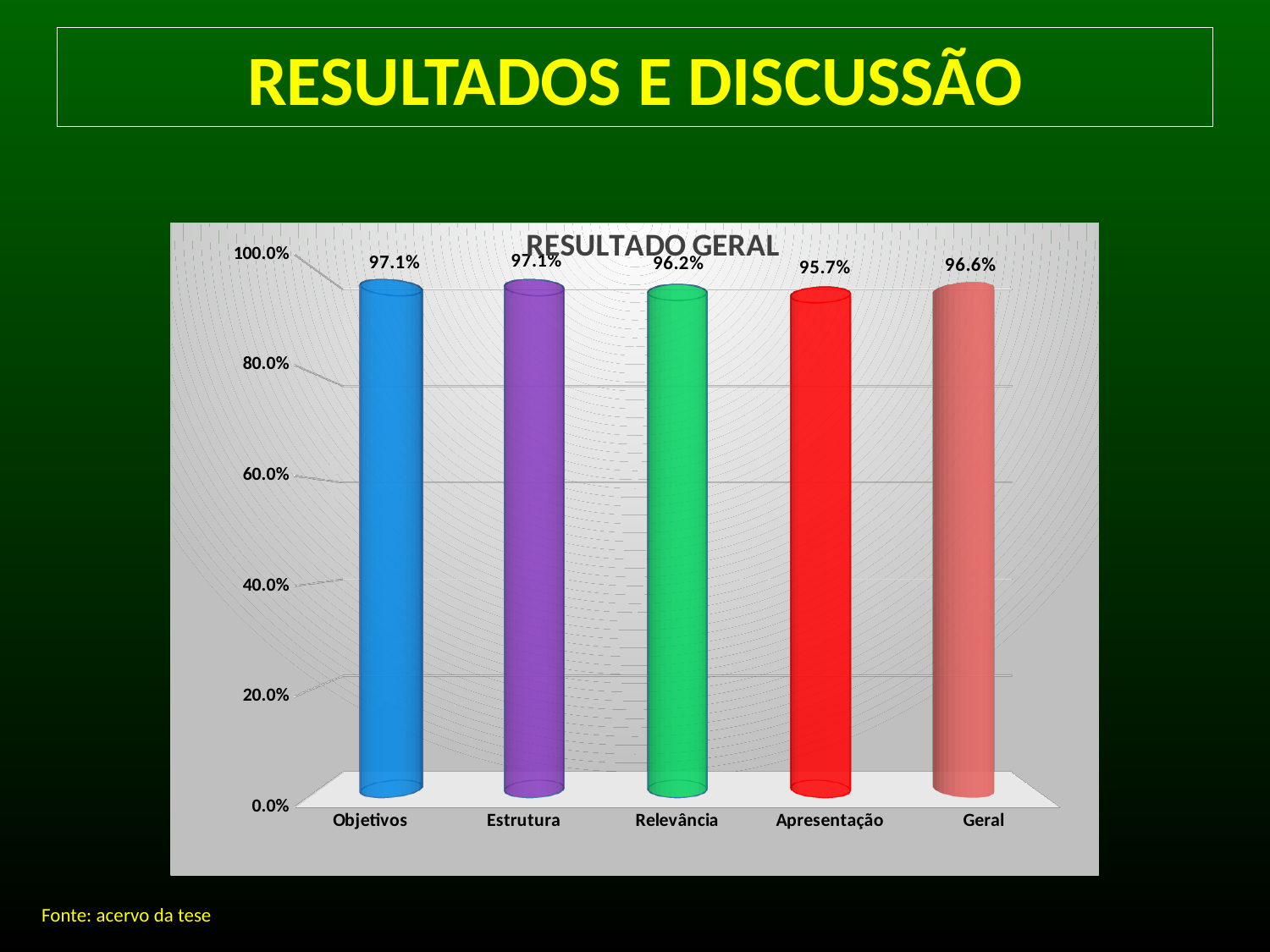
What is the difference between the values for Objetivos and Apresentação? 1.4% What is the value for Relevância? 96.2% What is the value for Apresentação? 95.7% What kind of chart is shown? bar chart Which category has the lowest value? Apresentação What is the title of the chart? RESULTADO GERAL How many categories are shown on the x axis? 5 What is the value for Geral? 96.6% What is the value for Objetivos? 97.1% Is the value for Estrutura greater or less than 80.0%? greater What is the difference between the values for Geral and Relevância? 0.4% Which is larger, the value for Relevância or the value for Apresentação? Relevância